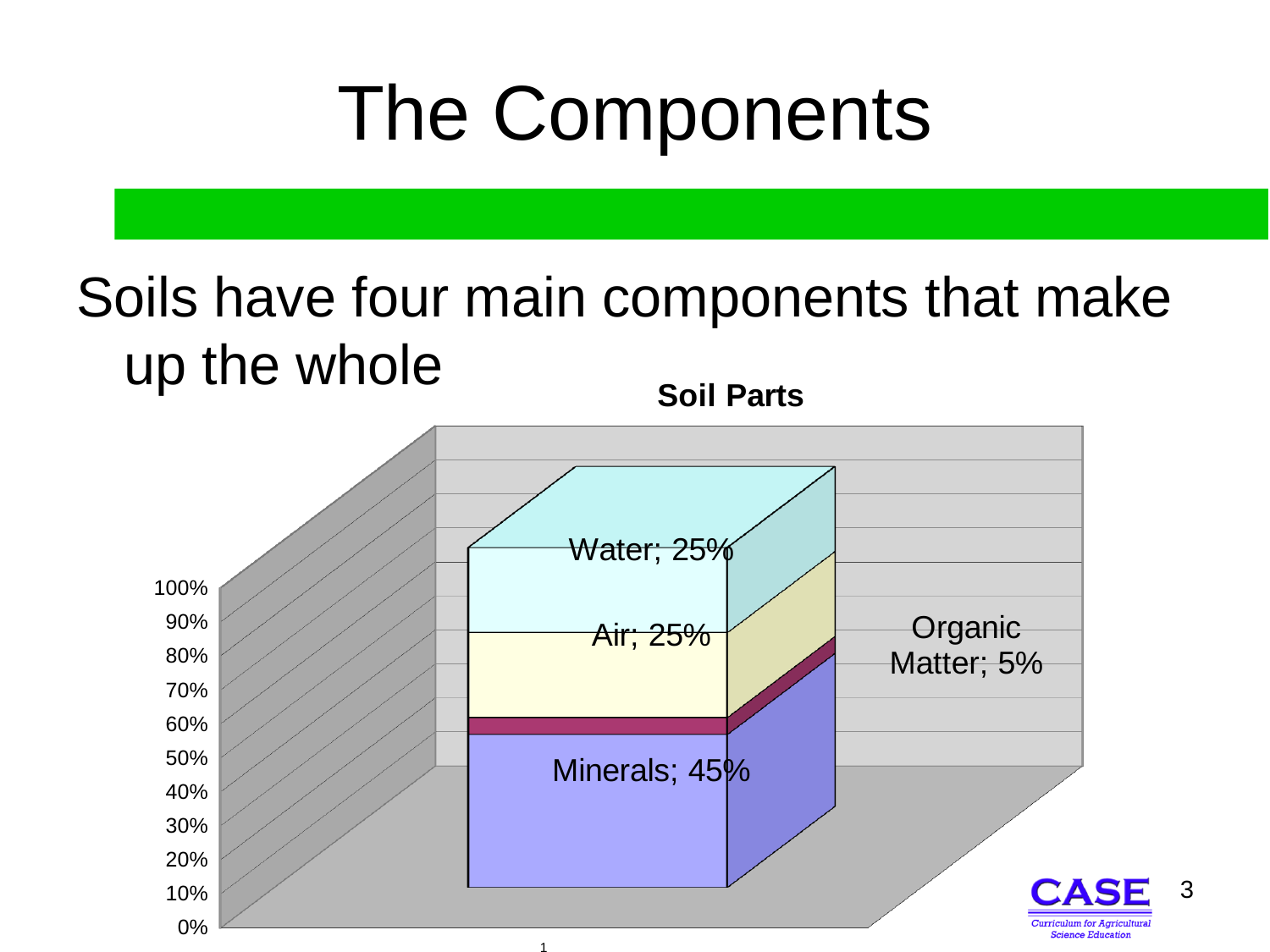
Which soil component has the smallest value in the Soil Parts chart? Organic Matter What is the value for Air in the Soil Parts chart? 25% What is the title of the chart on the slide? Soil Parts Which is larger in the Soil Parts chart, Minerals or Water? Minerals What is the value for Water in the Soil Parts chart? 25% Which soil component has the largest value in the Soil Parts chart? Minerals How many soil components are shown in the Soil Parts chart? 4 What kind of chart is the Soil Parts chart? Stacked bar chart What is the total of all segments in the stacked bar of the Soil Parts chart? 100% What is the value for Minerals in the Soil Parts chart? 45% What is the difference between the Minerals value and the Organic Matter value in the Soil Parts chart? 40% What is the value for Organic Matter in the Soil Parts chart? 5%